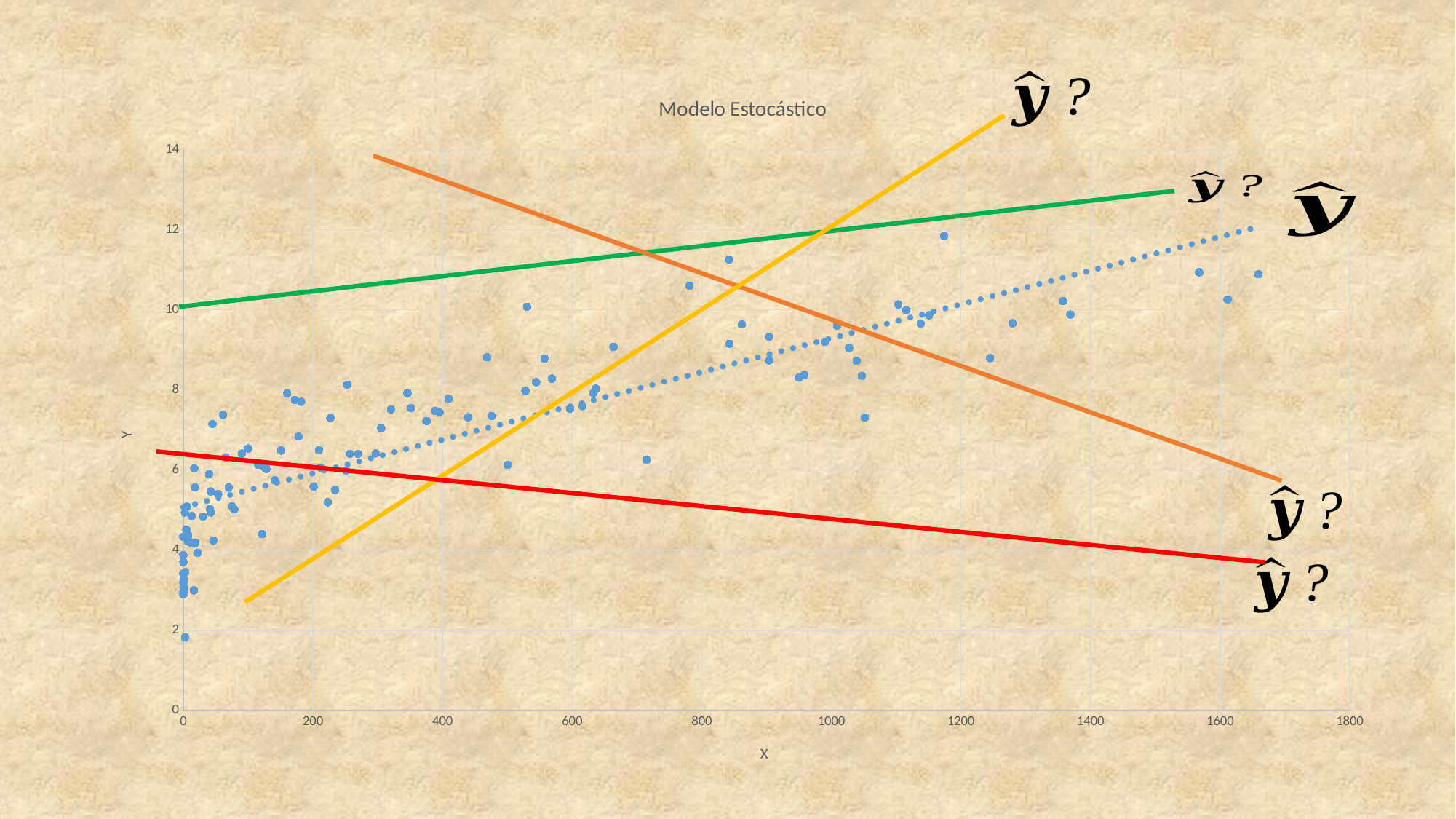
What is the highest tick value shown on the y axis? 14 Does the red line rise or fall as X increases? fall What is the title of the chart? Modelo Estocástico What is the highest tick value shown on the x axis? 1800 Does the orange line rise or fall as X increases? fall What is the label of the horizontal axis of the chart? X What kind of chart is shown on the slide? scatter plot At X = 0, which line is higher on the chart, the green line or the red line? green line Does the yellow line rise or fall as X increases? rise Is the Y value of the highest blue scatter point greater or less than 10? greater